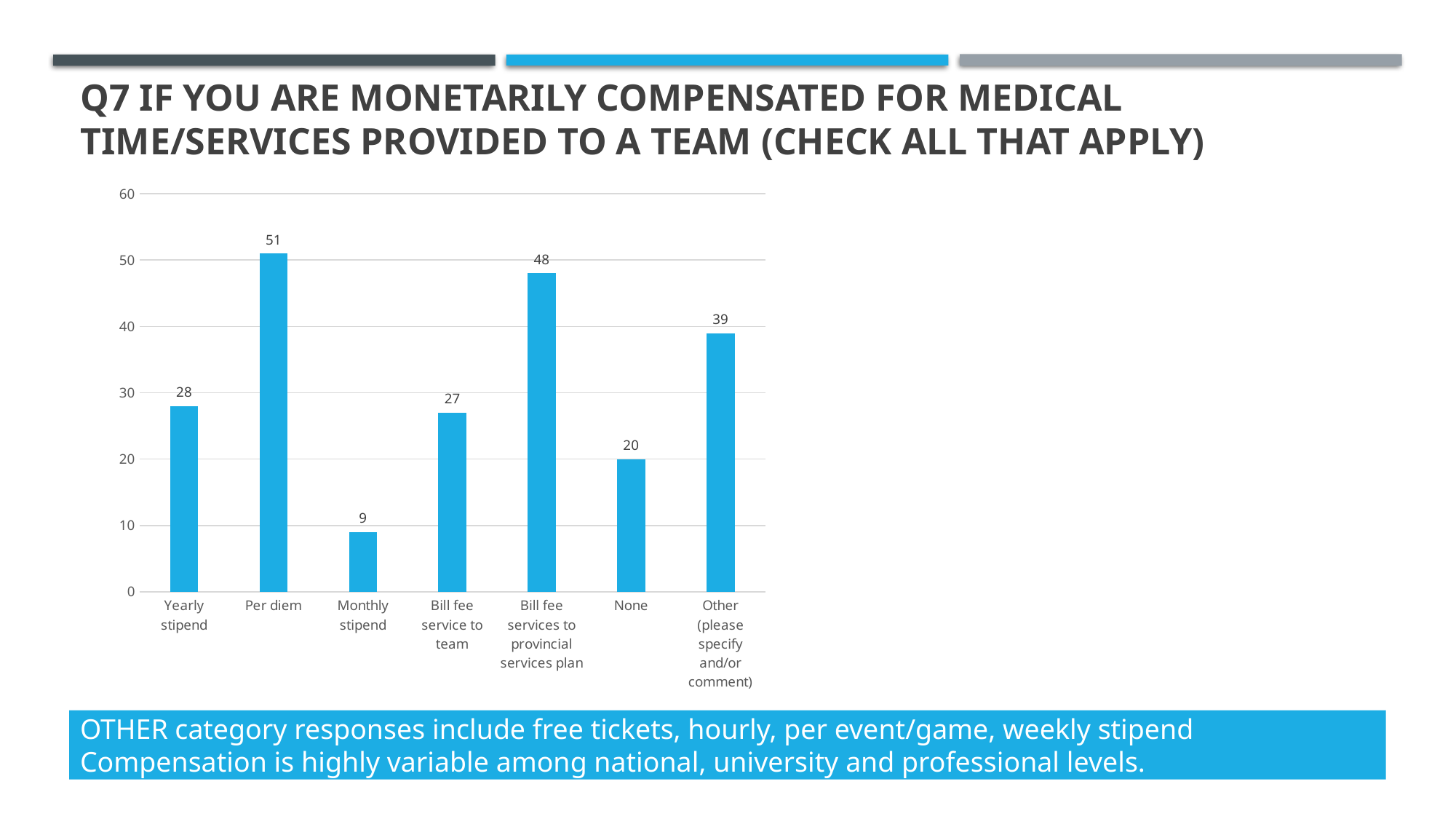
What is the value for Per diem? 51 What is the difference between the values for Per diem and Bill fee services to provincial services plan? 3 Which category has the highest value? Per diem Which is larger, the value for Other (please specify and/or comment) or the value for Yearly stipend? Other (please specify and/or comment) How many categories are shown on the x axis? 7 What is the value for Monthly stipend? 9 What is the value for Bill fee services to provincial services plan? 48 What is the value for Bill fee service to team? 27 What is the value for None? 20 Which category has the lowest value? Monthly stipend What is the difference between the values for Yearly stipend and Monthly stipend? 19 What kind of chart is shown on the slide? Bar chart